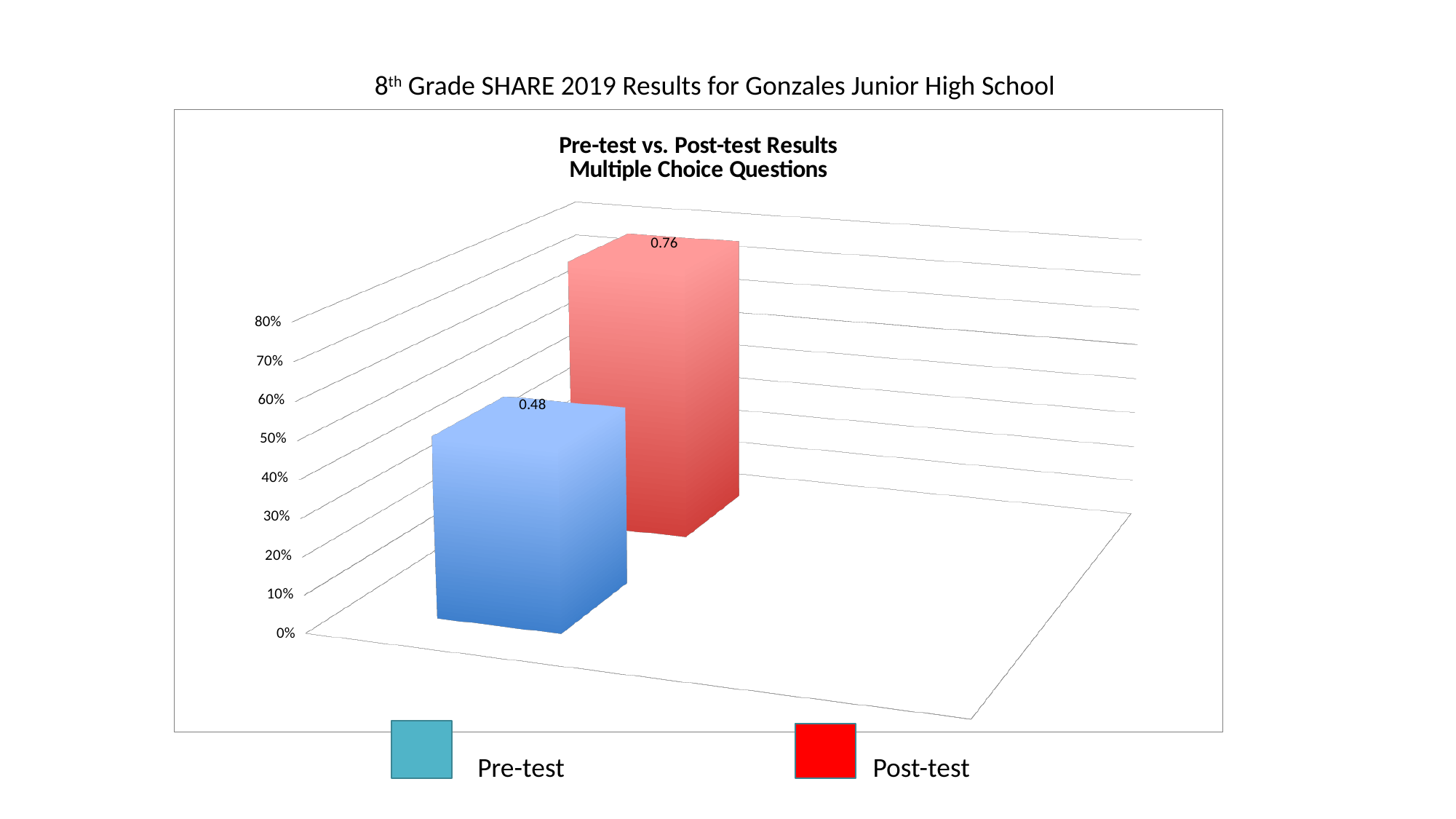
Is the Pre-test bar greater or less than 50% on the axis? less Which bar is the shortest in the chart? Pre-test How many bars are plotted in the chart? 2 Is the Post-test bar greater or less than 70% on the axis? greater What type of chart is shown on the slide? Bar chart How many entries does the legend below the chart list? 2 What is the title of the chart? Pre-test vs. Post-test Results Multiple Choice Questions Which bar is taller, Pre-test or Post-test? Post-test Is the Pre-test value larger or smaller than the Post-test value? smaller What is the data label shown on the Post-test bar? 0.76 What is the data label shown on the Pre-test bar? 0.48 What is the difference between the Post-test and Pre-test data labels? 0.28